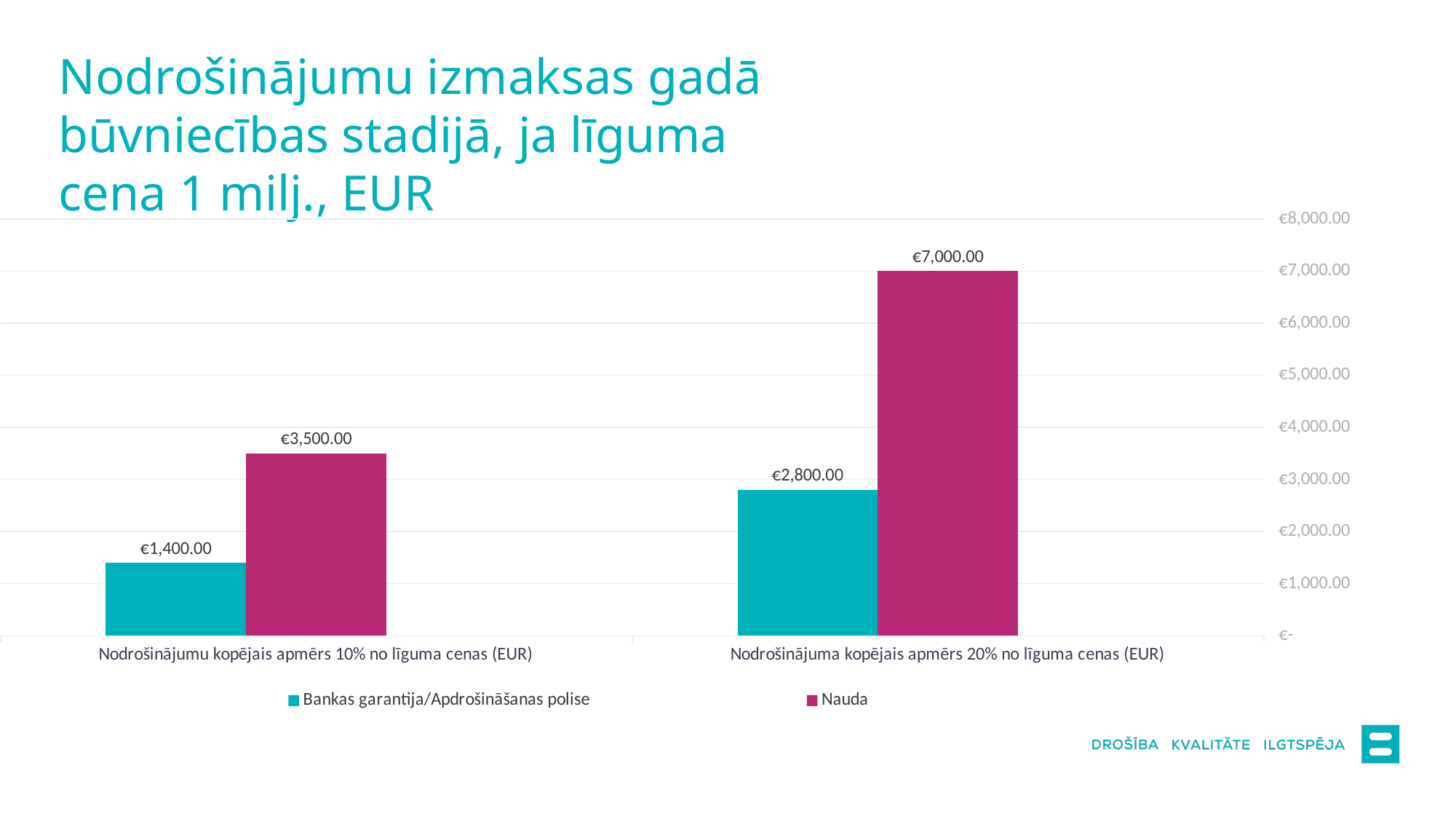
Which is larger: Nauda for the 10% category or Bankas garantija/Apdrošināšanas polise for the 20% category? Nauda for the 10% category How many categories are shown on the x axis? 2 Which bar has the highest value on the chart? Nauda for Nodrošinājuma kopējais apmērs 20% no līguma cenas (EUR) What is the value of Bankas garantija/Apdrošināšanas polise for 'Nodrošinājuma kopējais apmērs 20% no līguma cenas (EUR)'? €2,800.00 What is the value of Bankas garantija/Apdrošināšanas polise for 'Nodrošinājumu kopējais apmērs 10% no līguma cenas (EUR)'? €1,400.00 Which bar has the lowest value on the chart? Bankas garantija/Apdrošināšanas polise for Nodrošinājumu kopējais apmērs 10% no līguma cenas (EUR) How many series does the legend list? 2 What is the value of Nauda for 'Nodrošinājumu kopējais apmērs 10% no līguma cenas (EUR)'? €3,500.00 What is the difference between Nauda and Bankas garantija/Apdrošināšanas polise for the 20% category? €4,200.00 What is the value of Nauda for 'Nodrošinājuma kopējais apmērs 20% no līguma cenas (EUR)'? €7,000.00 What type of chart is shown on the slide? Bar chart What is the difference between Nauda and Bankas garantija/Apdrošināšanas polise for the 10% category? €2,100.00